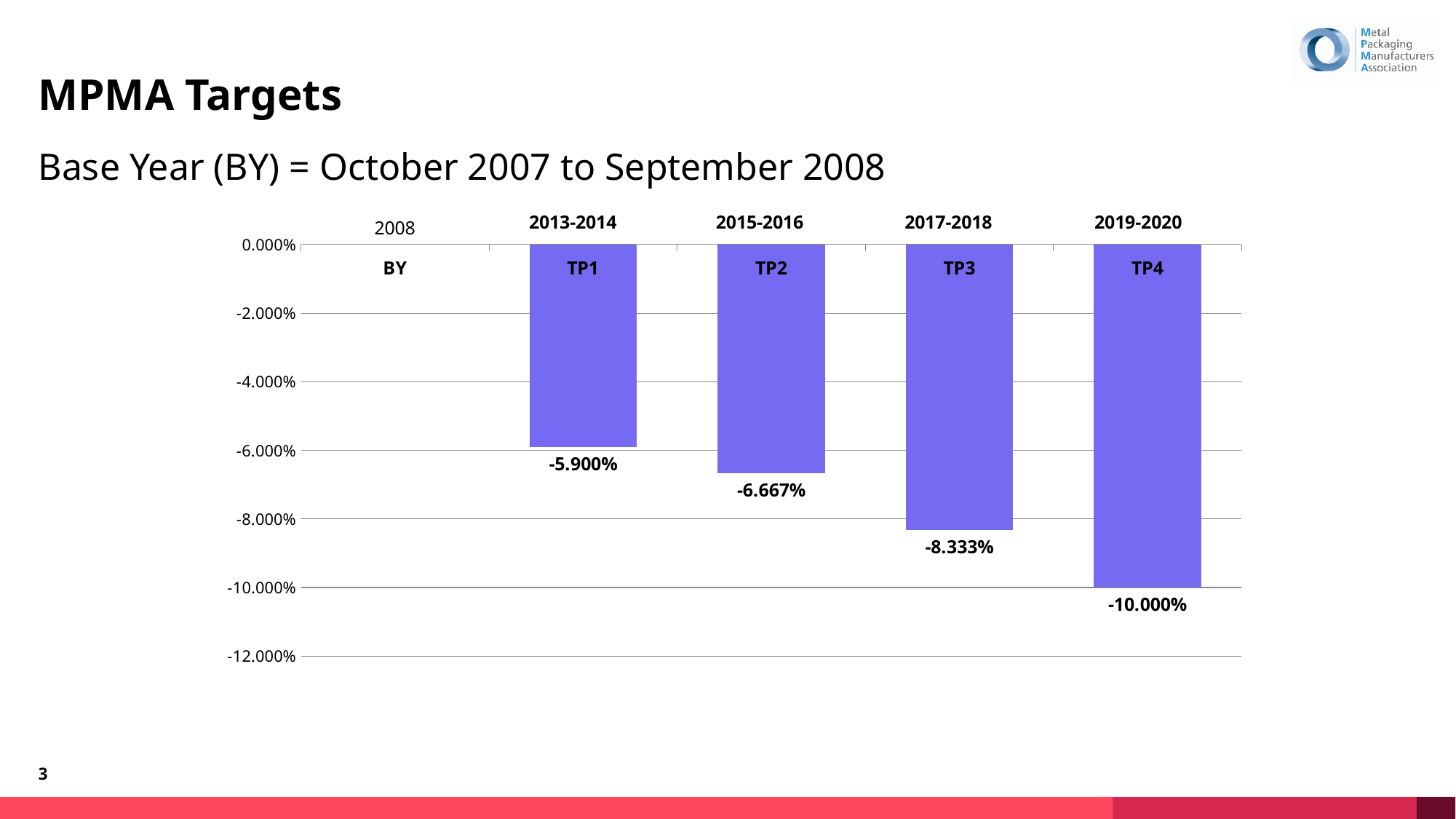
Which of the labelled target periods has the value closest to zero? TP1 (2013-2014) What is the value for TP1 (2013-2014)? -5.900% Do the values rise or fall from TP1 to TP4 along the x axis? Fall What kind of chart is shown on the slide? Bar chart What is the difference between the values for TP4 and TP1? 4.100% What is the value for TP2 (2015-2016)? -6.667% What is the value for TP3 (2017-2018)? -8.333% What is the difference between the values for TP3 and TP2? 1.666% Which target period has the lowest (most negative) value? TP4 (2019-2020) What is the value for TP4 (2019-2020)? -10.000% Which is more negative, the value for TP2 or the value for TP3? TP3 How many target periods (TP1 to TP4) have bars plotted? 4